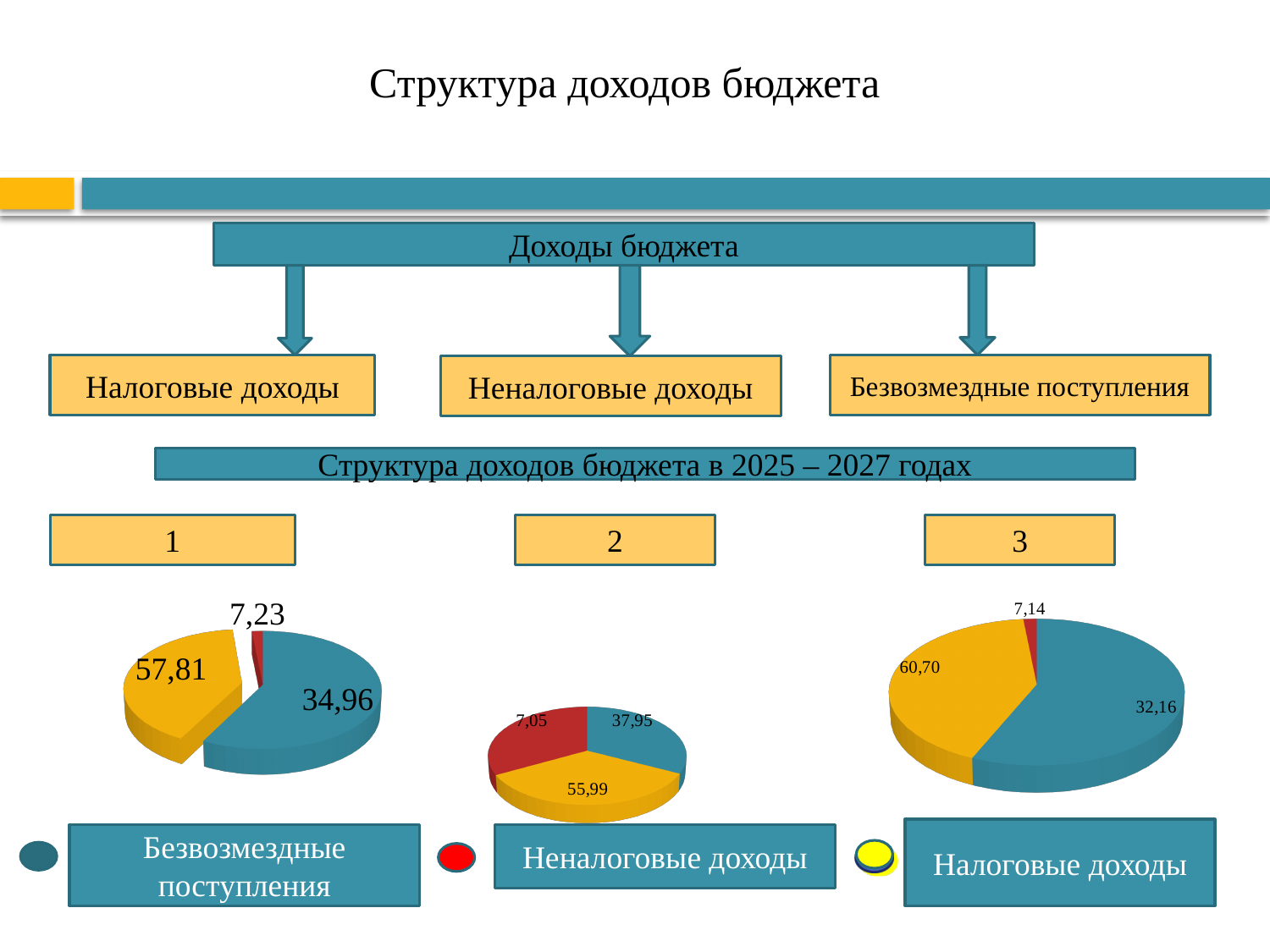
What is the difference between the Безвозмездные поступления value in chart 2 and in chart 3? 5,79 In the pie chart under label 2, what is the value of the red slice (Неналоговые доходы)? 7,05 How many slices does the pie chart under label 2 have? 3 In the pie chart under label 1, what is the value of the yellow slice (Налоговые доходы)? 57,81 What type of chart is shown under label 3? Pie chart In the pie chart under label 3, which category has the largest slice? Налоговые доходы Across the three pie charts, which one has the highest value for Налоговые доходы? Chart 3 (60,70) In the pie chart under label 1, which category has the smallest slice? Неналоговые доходы In the pie chart under label 2, what is the difference between the Налоговые доходы value and the Безвозмездные поступления value? 18,04 In the pie chart under label 3, what is the value of the teal slice (Безвозмездные поступления)? 32,16 Which category does the red colour represent in the legend below the pie charts? Неналоговые доходы Which is larger in the pie chart under label 1: the Безвозмездные поступления slice or the Налоговые доходы slice? Налоговые доходы